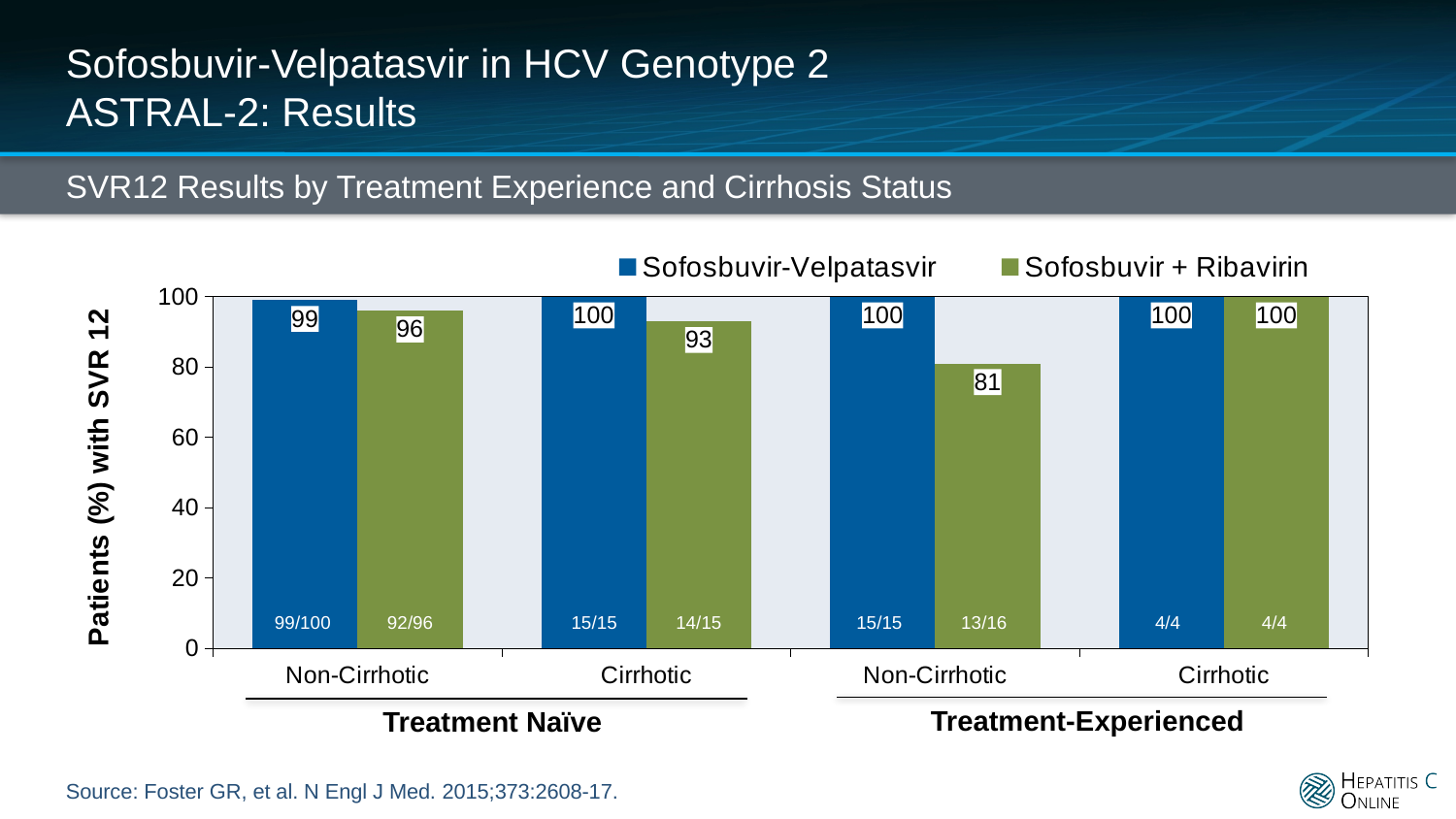
What kind of chart is shown on the slide? Bar chart In Treatment Naïve Cirrhotic patients, which regimen has the higher SVR12 rate? Sofosbuvir-Velpatasvir What is the SVR12 rate for Sofosbuvir-Velpatasvir in Treatment Naïve Non-Cirrhotic patients? 99 Which group has the lowest SVR12 rate on the chart? Sofosbuvir + Ribavirin, Treatment-Experienced Non-Cirrhotic How many category groups are shown along the x axis? 4 Is the SVR12 rate for Sofosbuvir + Ribavirin in Treatment-Experienced Non-Cirrhotic patients greater or less than 80? greater How many series does the legend list? 2 What is the label of the y axis? Patients (%) with SVR 12 What is the difference in SVR12 rate between Sofosbuvir-Velpatasvir and Sofosbuvir + Ribavirin in Treatment-Experienced Non-Cirrhotic patients? 19 What is the SVR12 rate for Sofosbuvir + Ribavirin in Treatment-Experienced Non-Cirrhotic patients? 81 What is the SVR12 rate for Sofosbuvir + Ribavirin in Treatment Naïve Cirrhotic patients? 93 How many patients achieved SVR12 out of the total in the Sofosbuvir + Ribavirin Treatment Naïve Non-Cirrhotic group? 92/96